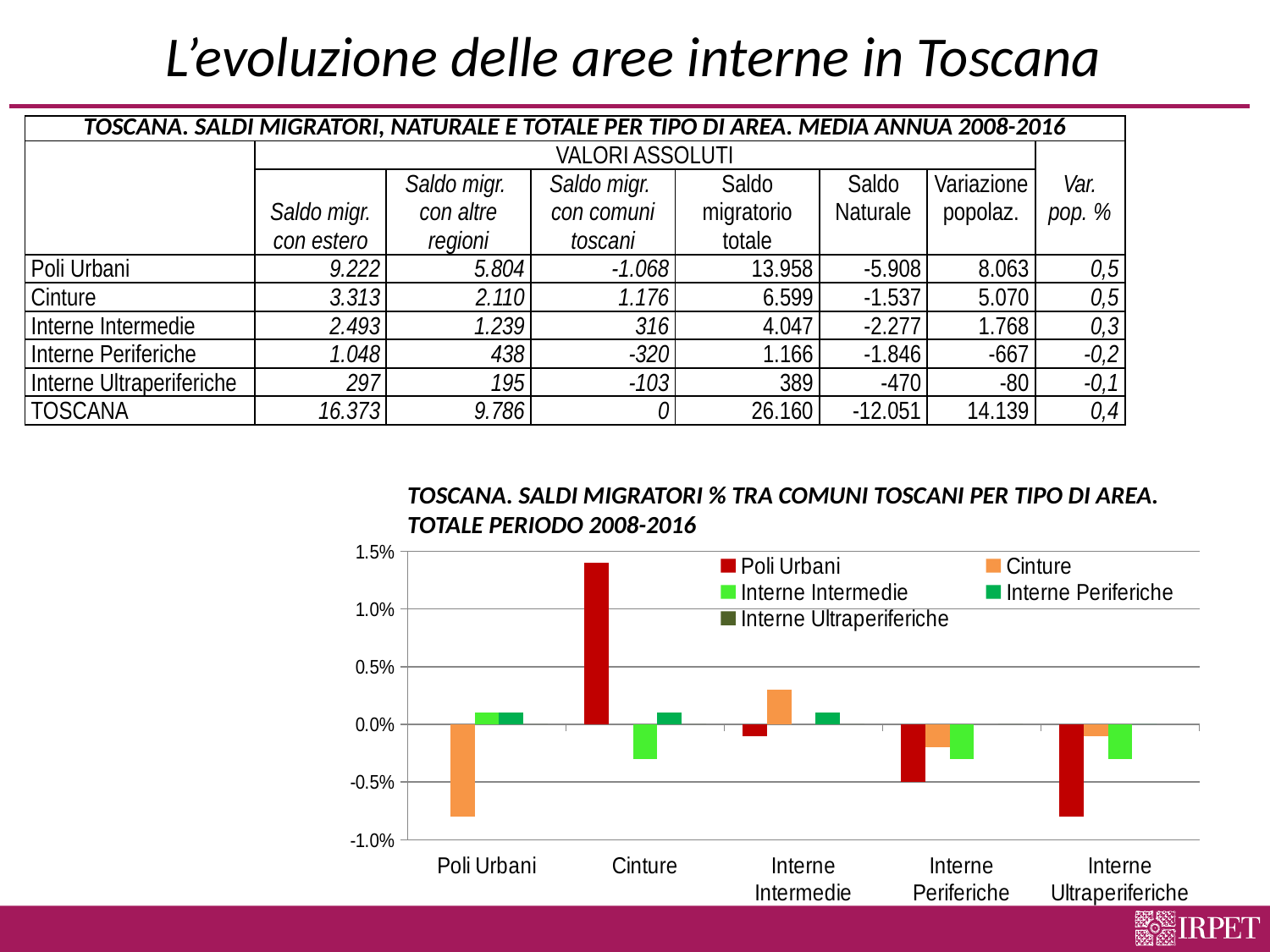
What is the title of the chart? TOSCANA. SALDI MIGRATORI % TRA COMUNI TOSCANI PER TIPO DI AREA. TOTALE PERIODO 2008-2016 In the chart, which is larger: the Poli Urbani series value for the Cinture category or the Cinture series value for the Interne Intermedie category? Poli Urbani series value for the Cinture category How many series does the chart's legend list? 5 How many categories are shown along the x axis of the chart? 5 In the chart, is the value of the Poli Urbani series for the Interne Ultraperiferiche category greater or less than -0.5%? less What kind of chart is shown on the slide? Bar chart What colour represents the Cinture series in the chart's legend? Orange Which bar in the chart reaches the highest value? Poli Urbani series in the Cinture category In the chart, is the value of the Cinture series for the Poli Urbani category greater or less than -0.5%? less In the chart, is the value of the Interne Intermedie series for the Cinture category greater or less than 0.0%? less